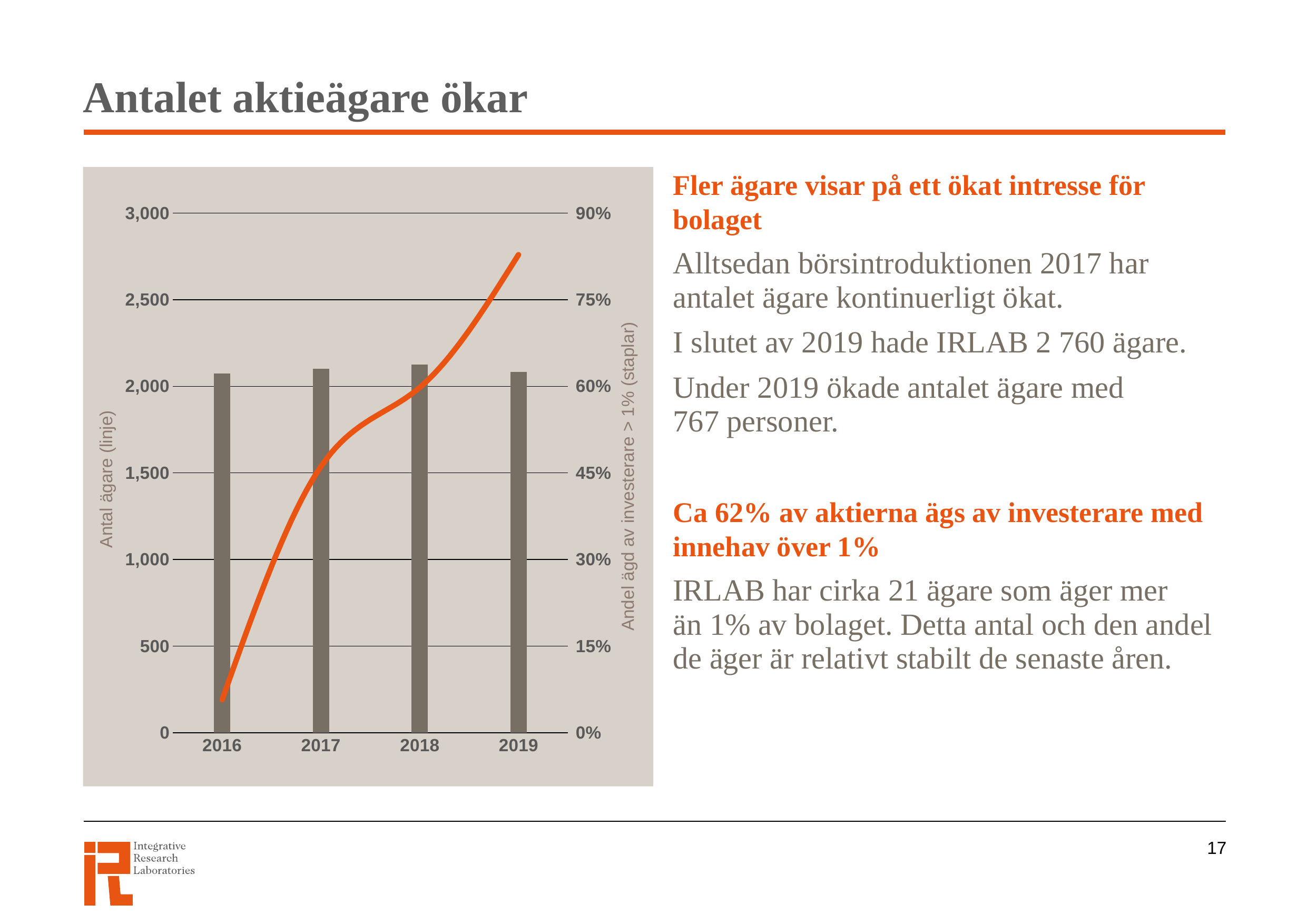
In which year is the orange line (Antal ägare) at its lowest? 2016 In which year is the orange line (Antal ägare) at its highest? 2019 Does the orange line (Antal ägare) rise or fall from 2016 to 2019? Rises What is the title of the right vertical axis of the chart? Andel ägd av investerare > 1% (staplar) Is the value of the orange line (Antal ägare) for 2017 greater or less than 1,000? greater What is the title of the left vertical axis of the chart? Antal ägare (linje) How many years are shown on the x axis of the chart? 4 Is the value of the orange line (Antal ägare) for 2019 greater or less than 2,500? greater Is the bar value (Andel ägd av investerare > 1%) for 2016 greater or less than 45%? greater Is the orange line value for 2019 larger or smaller than the orange line value for 2017? Larger What kind of chart is shown on the slide? A combined bar and line chart